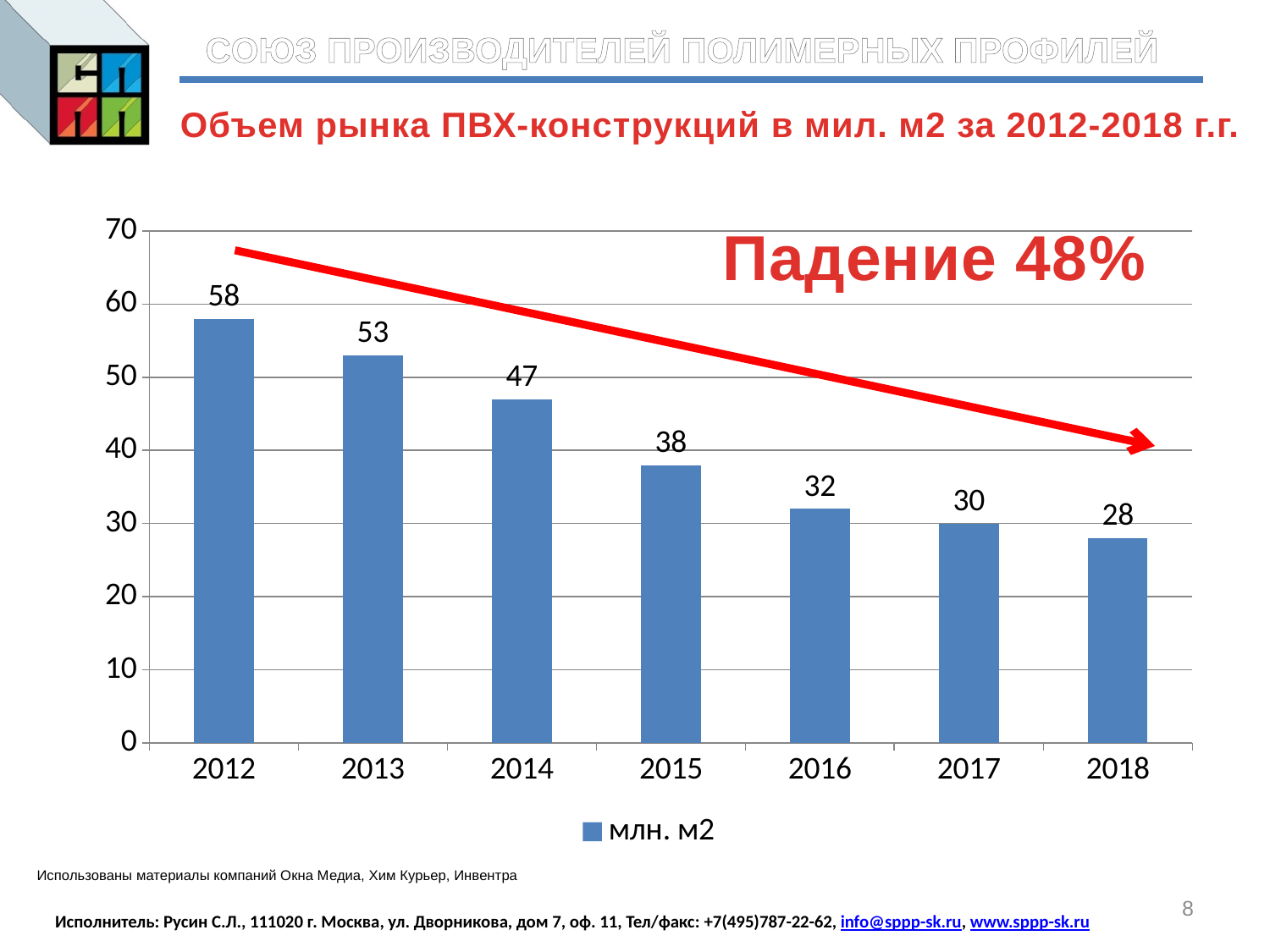
Which year has the highest value? 2012 What is the value for 2012? 58 Is the value for 2017 greater or less than 40? less How many years are shown on the x axis? 7 Which is larger, the value for 2013 or the value for 2016? 2013 What is the difference between the values for 2012 and 2018? 30 Do the values rise or fall from 2012 to 2018? fall Which year has the lowest value? 2018 What is the difference between the values for 2014 and 2015? 9 What is the value for 2018? 28 What kind of chart is this? bar chart What is the value for 2015? 38